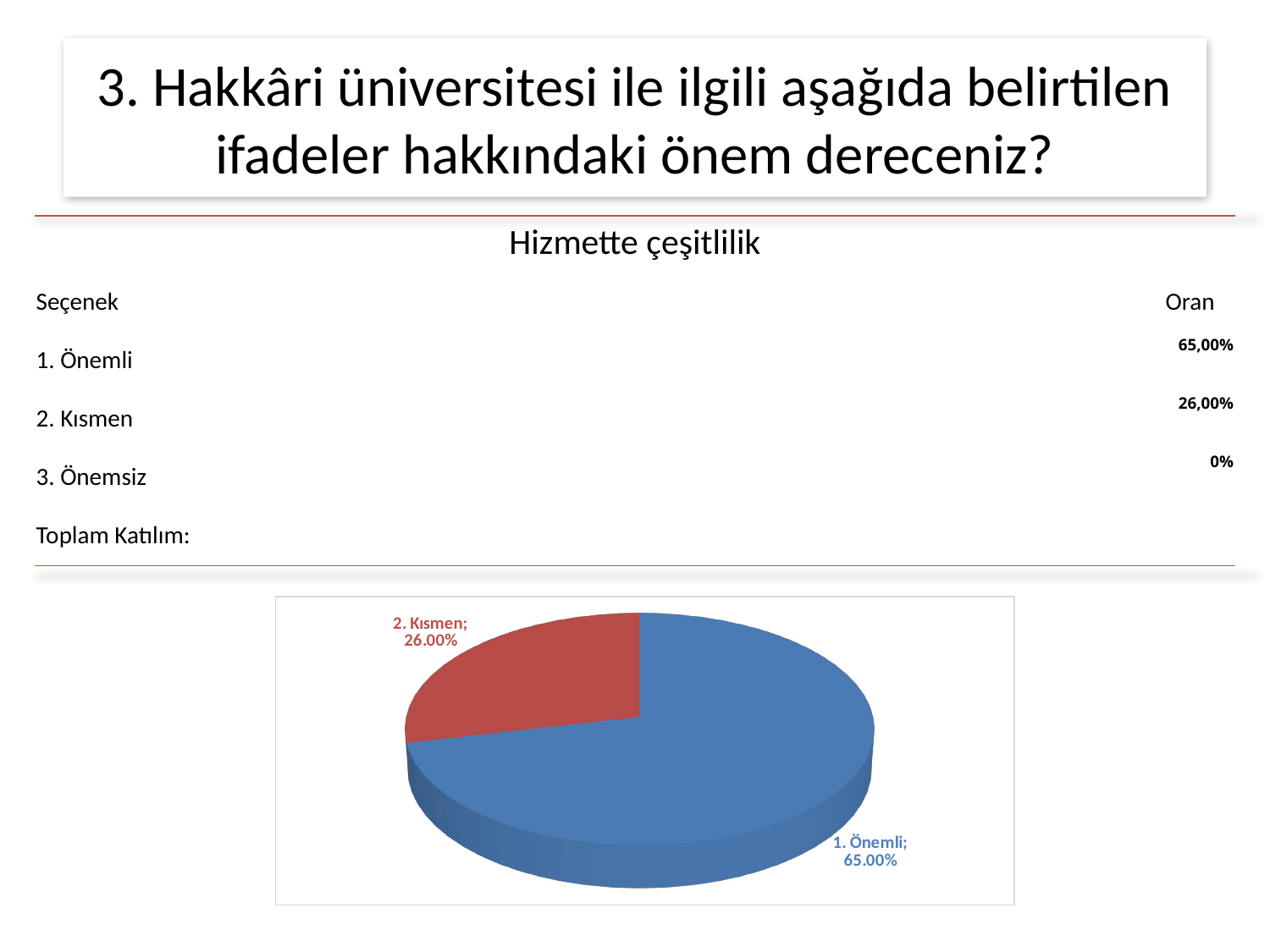
What kind of chart is shown on the slide? Pie chart Is the share for "1. Önemli" in the pie chart greater or less than 50%? greater What colour is the "1. Önemli" slice in the pie chart? Blue What share of the pie chart does the slice labelled "1. Önemli" represent? 65.00% What colour is the "2. Kısmen" slice in the pie chart? Red What share of the pie chart does the slice labelled "2. Kısmen" represent? 26.00% How many labelled slices does the pie chart show? 2 By how many percentage points does the "1. Önemli" slice exceed the "2. Kısmen" slice in the pie chart? 39.00 percentage points Is the share for "2. Kısmen" in the pie chart greater or less than 50%? less Which is larger in the pie chart, the share for "1. Önemli" or the share for "2. Kısmen"? 1. Önemli Which slice of the pie chart is the largest? 1. Önemli Which labelled slice of the pie chart is the smallest? 2. Kısmen